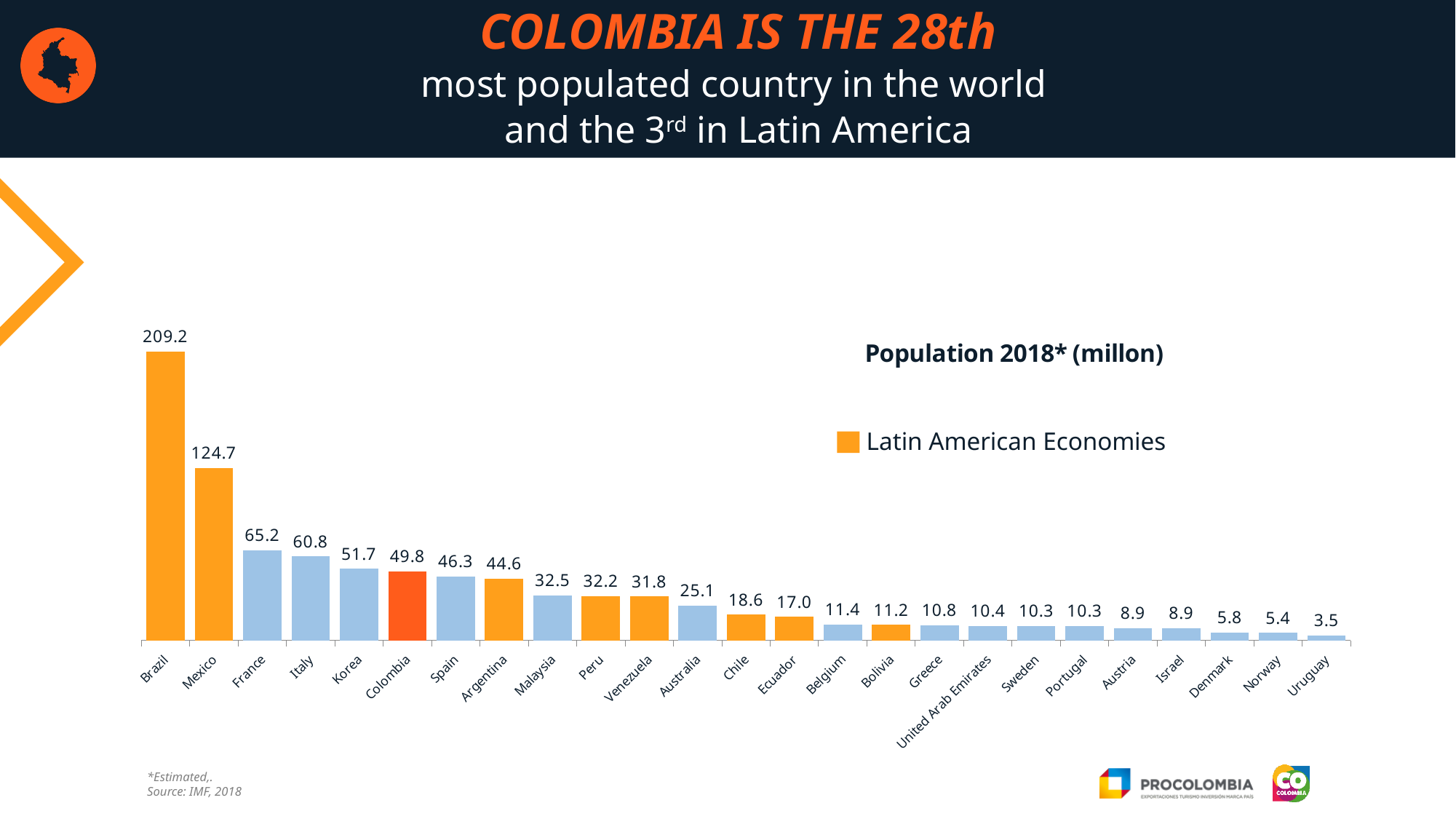
Which country has the lowest population in the chart? Uruguay What is the difference between the population values of Colombia and Spain? 3.5 What is the population value shown for Belgium? 11.4 Which has a larger population value, Chile or Ecuador? Chile What is the title of the chart? Population 2018* (millon) What type of chart is shown on the slide? Bar chart How many countries are shown in the chart? 25 What is the difference between the population values of Brazil and Mexico? 84.5 What is the population value shown for Argentina? 44.6 What is the population value shown for Colombia? 49.8 Which has a larger population value, France or Italy? France Which country has the highest population in the chart? Brazil